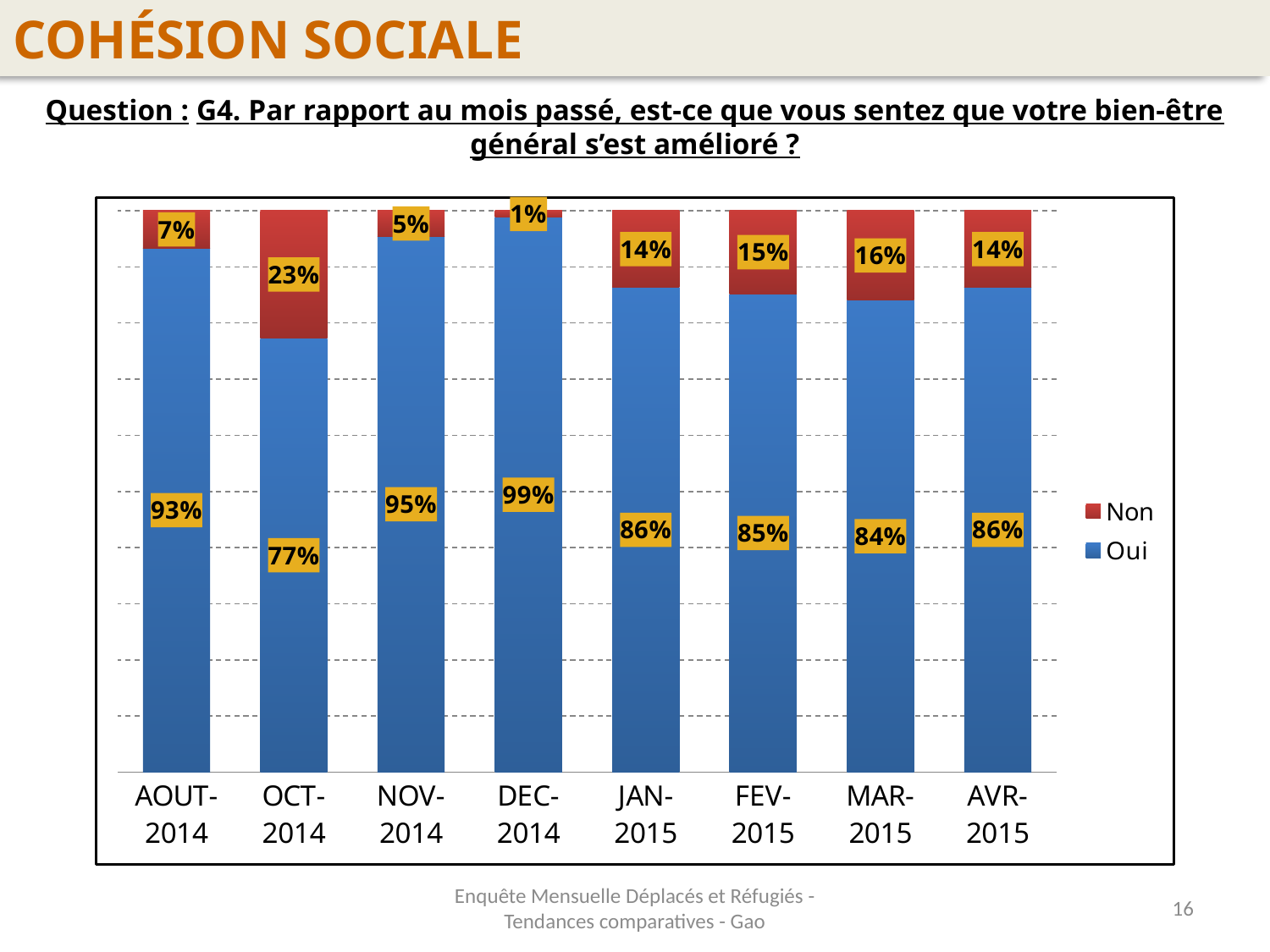
In which month is the Oui value lowest? OCT-2014 Which is larger, the Non value for FEV-2015 or the Non value for MAR-2015? MAR-2015 What is the value for Oui in DEC-2014? 99% In which month is the Non value lowest? DEC-2014 What is the value for Oui in MAR-2015? 84% What is the value for Non in OCT-2014? 23% What is the difference between the Oui values for AOUT-2014 and OCT-2014? 16% How many months are shown on the x axis? 8 In which month is the Non value highest? OCT-2014 What kind of chart is shown on the slide? Stacked bar chart How many series does the legend list? 2 Which colour represents the Non series? Red